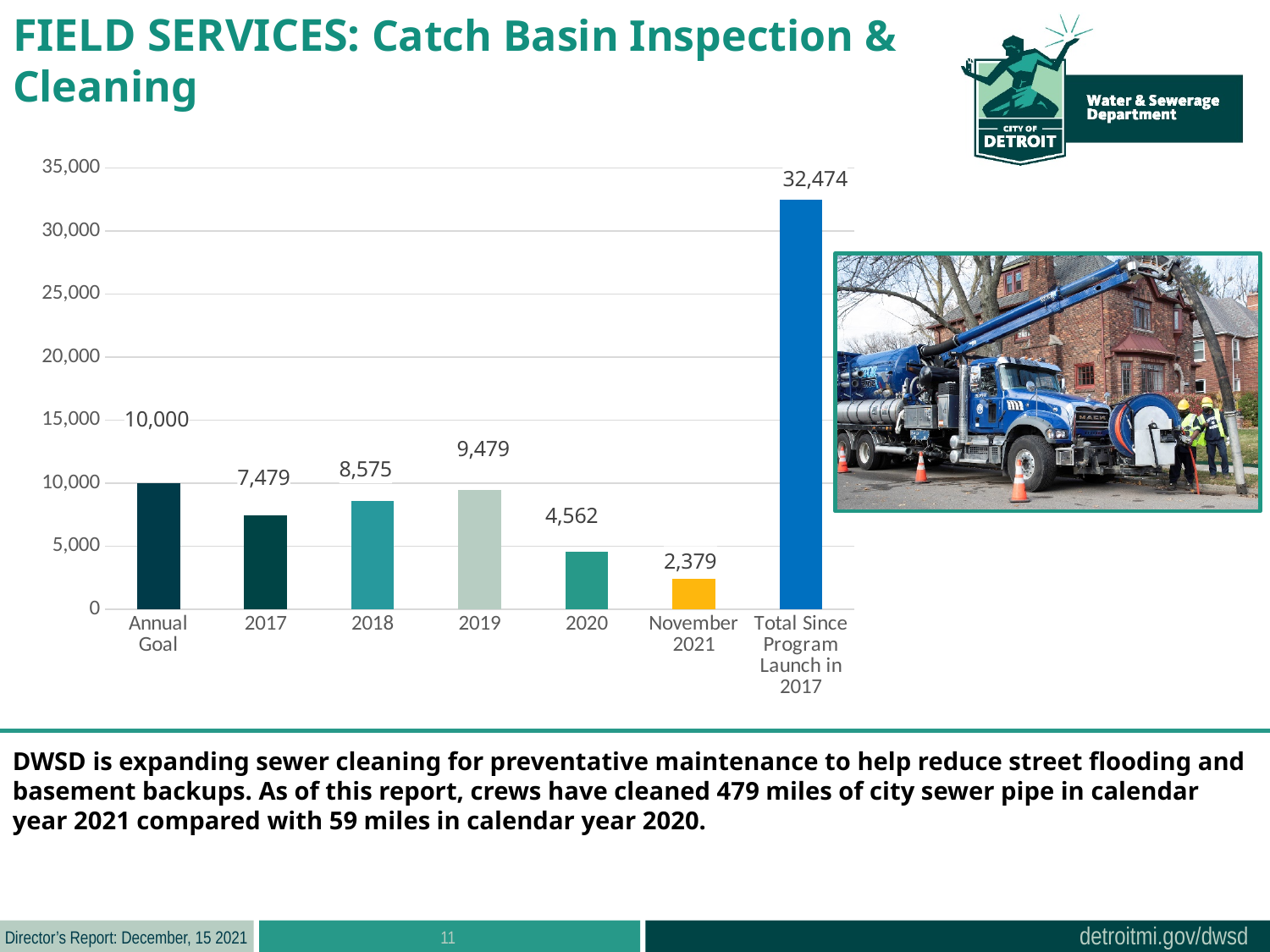
What is the value for 2019? 9,479 What is the difference between the Annual Goal and the value for 2018? 1,425 What is the value for Total Since Program Launch in 2017? 32,474 What kind of chart is shown on the slide? bar chart How many bars are shown in the chart? 7 Is the value for 2020 greater or less than 5,000? less Which is larger, the value for 2017 or the value for 2018? 2018 What is the difference between the values for 2019 and 2020? 4,917 Which category has the lowest value? November 2021 Which category has the highest value? Total Since Program Launch in 2017 What is the value for November 2021? 2,379 What is the value for the Annual Goal bar? 10,000